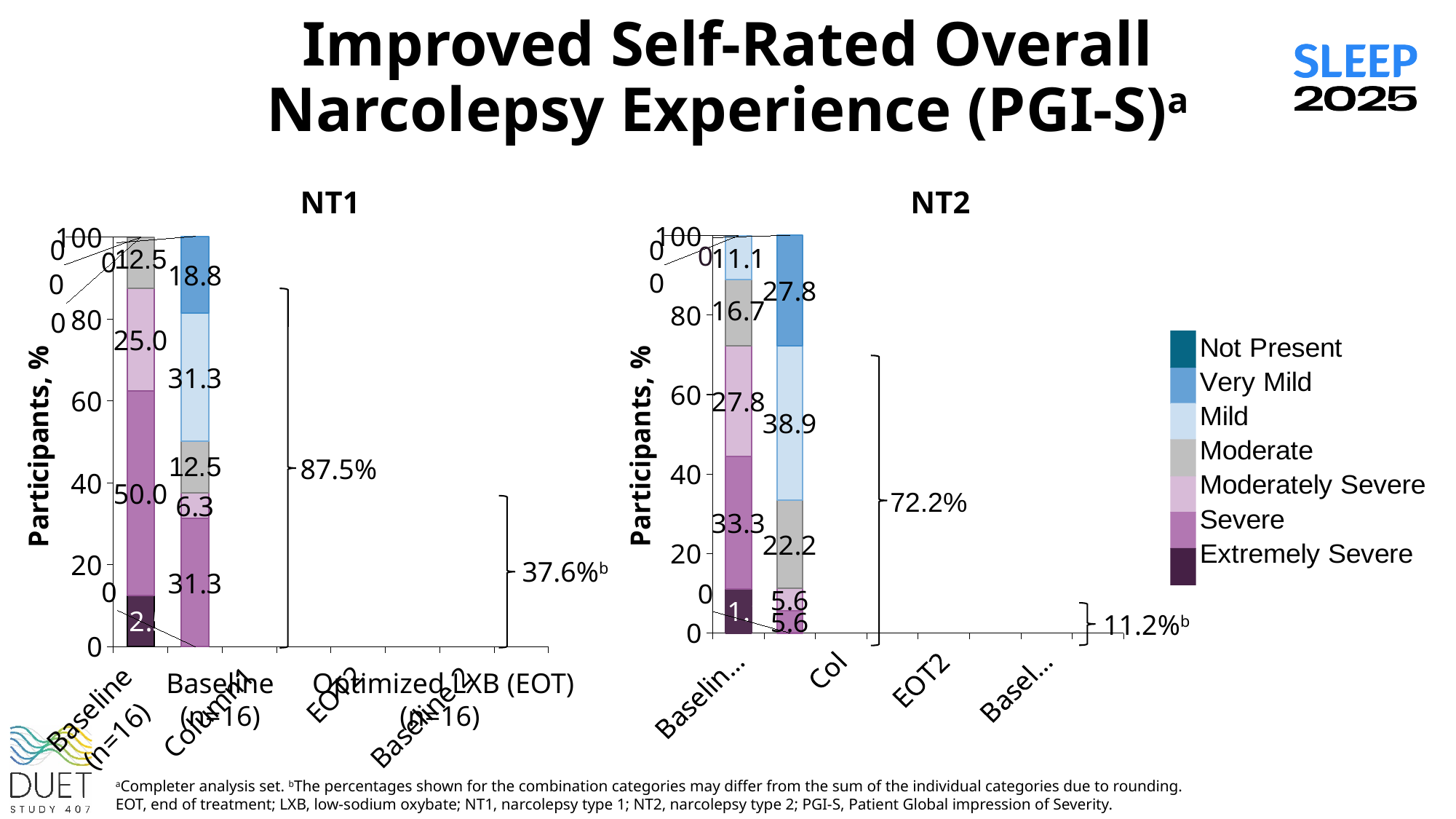
In the NT1 chart, is the Moderately Severe percentage larger at Baseline or at Optimized LXB (EOT)? Baseline In the NT1 chart, what percentage of participants rated their narcolepsy as Mild at Optimized LXB (EOT)? 31.3 In the NT2 chart, what percentage of participants are in the Mild category in the right-hand (EOT) bar? 38.9 In the NT2 chart, what percentage of participants are in the Severe category in the left-hand (Baseline) bar? 33.3 In the NT1 chart, what combined percentage is shown by the bracket next to the Baseline bar? 87.5% In the NT1 chart, what percentage of participants rated their narcolepsy as Severe at Baseline (n=16)? 50.0 How many severity categories does the legend list? 7 In the NT1 chart, what is the difference between the Severe percentage at Baseline and at Optimized LXB (EOT)? 18.7 In the NT1 chart, what percentage of participants rated their narcolepsy as Very Mild at Optimized LXB (EOT)? 18.8 In the NT2 chart, what combined percentage is shown by the bracket next to the Baseline bar? 72.2% What kind of chart is used for the NT1 and NT2 panels? Stacked bar chart In the NT2 chart, what percentage of participants are in the Moderate category in the right-hand (EOT) bar? 22.2